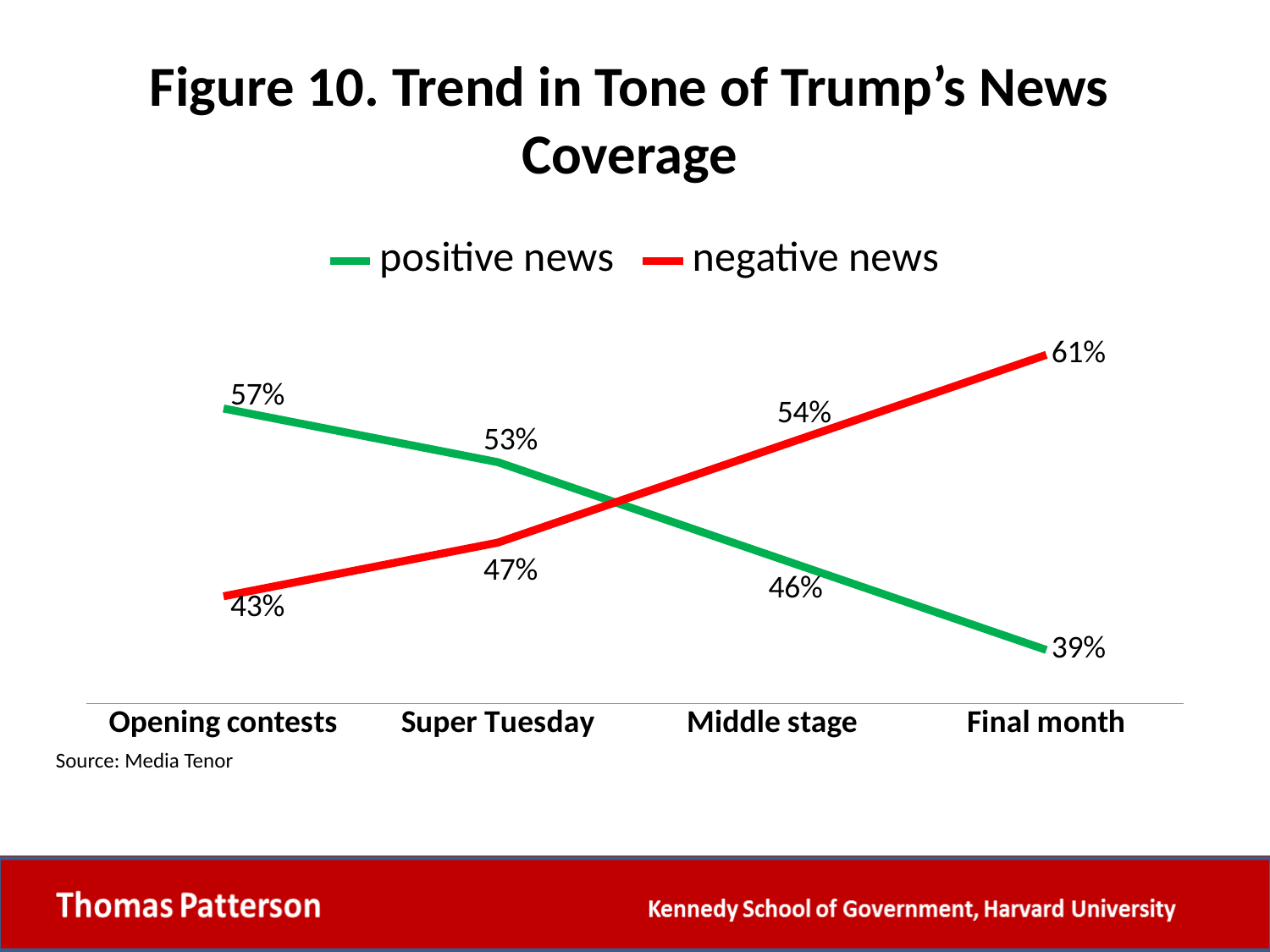
At which stage is positive news lowest? Final month What is the value for positive news at Middle stage? 46% How many series does the legend list? 2 Does positive news rise or fall from Opening contests to Final month? fall At which stage is negative news highest? Final month How many stages are shown on the x axis? 4 What is the value for negative news at Super Tuesday? 47% What is the value for negative news at Final month? 61% What is the value for positive news at Opening contests? 57% What is the difference between negative news and positive news at Final month? 22% What kind of chart is this? line chart Which is larger at Opening contests, positive news or negative news? positive news